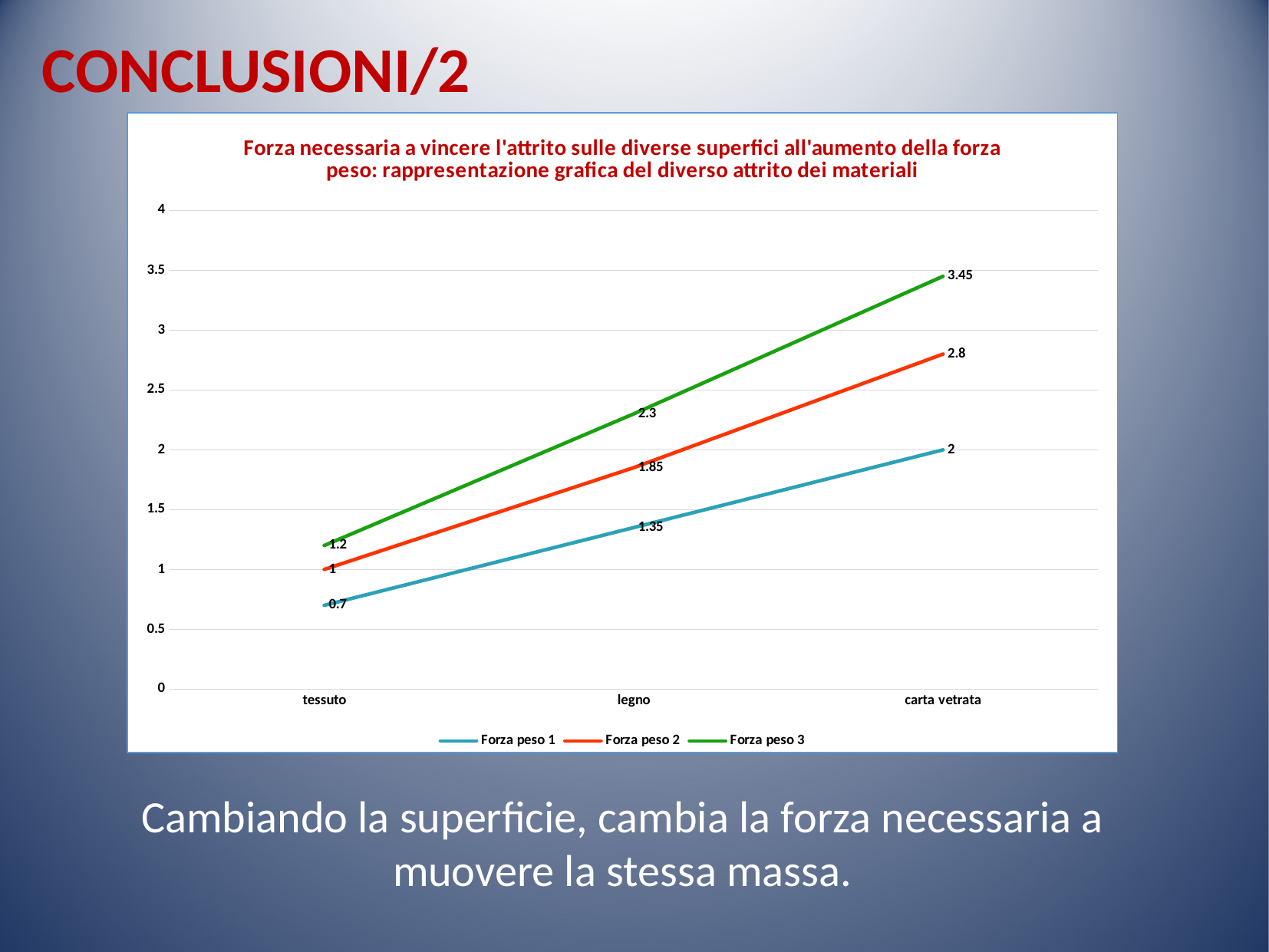
Which is larger for legno: Forza peso 2 or Forza peso 1? Forza peso 2 What is the difference between Forza peso 3 and Forza peso 1 for carta vetrata? 1.45 How many series does the legend list? 3 What is the value of Forza peso 3 for carta vetrata? 3.45 For which surface is the value of Forza peso 1 lowest? tessuto Which colour is used for the Forza peso 3 line? green How many categories are shown on the x axis? 3 What is the value of Forza peso 1 for tessuto? 0.7 For which surface is the value of Forza peso 3 highest? carta vetrata What is the value of Forza peso 2 for legno? 1.85 What kind of chart is shown on the slide? line chart Do the values of Forza peso 2 rise or fall from tessuto to carta vetrata? rise